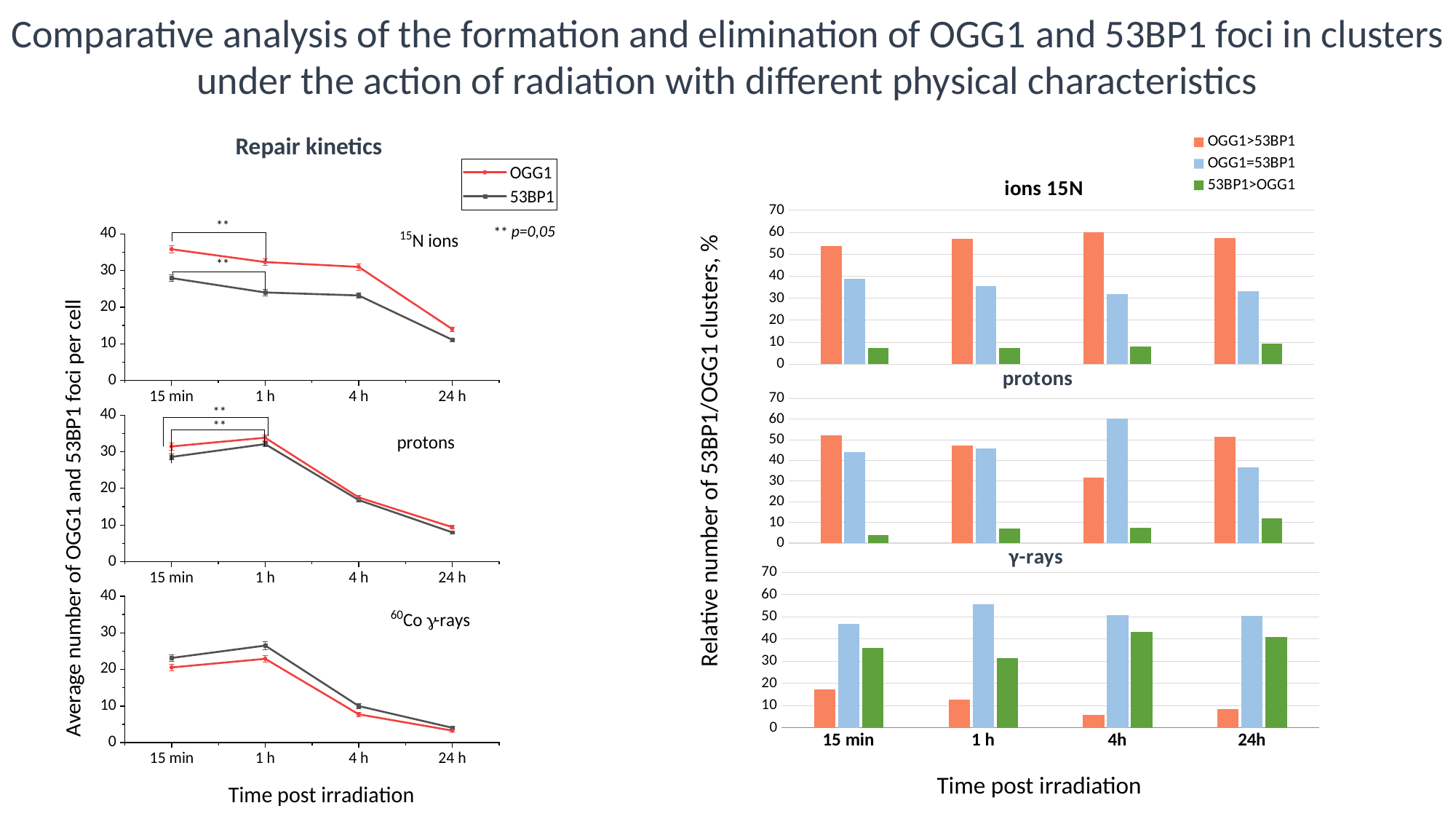
What kind of chart is the 'ions 15N' panel on the right of the slide? bar chart How many series does the legend of the bar charts on the right list? 3 What kind of chart is the 'Repair kinetics' panel for 15N ions on the left of the slide? line chart What is the y-axis label of the bar charts on the right of the slide? Relative number of 53BP1/OGG1 clusters, % In the 'Repair kinetics' line chart for 15N ions, does the OGG1 series rise or fall from 15 min to 24 h? fall In the 'Repair kinetics' line chart for 60Co γ-rays, which series is higher at 1 h, OGG1 or 53BP1? 53BP1 How many series does the legend of the 'Repair kinetics' line charts list? 2 How many time points are plotted on the x axis of the 'protons' bar chart? 4 In the 'ions 15N' bar chart, which series is lowest at 15 min? 53BP1>OGG1 In the 'γ-rays' bar chart, is the value for OGG1>53BP1 at 4h greater or less than 10? less In the 'protons' bar chart, at which time point is the OGG1=53BP1 series highest? 4h In the 'ions 15N' bar chart, is the value for OGG1>53BP1 at 15 min greater or less than 50? greater